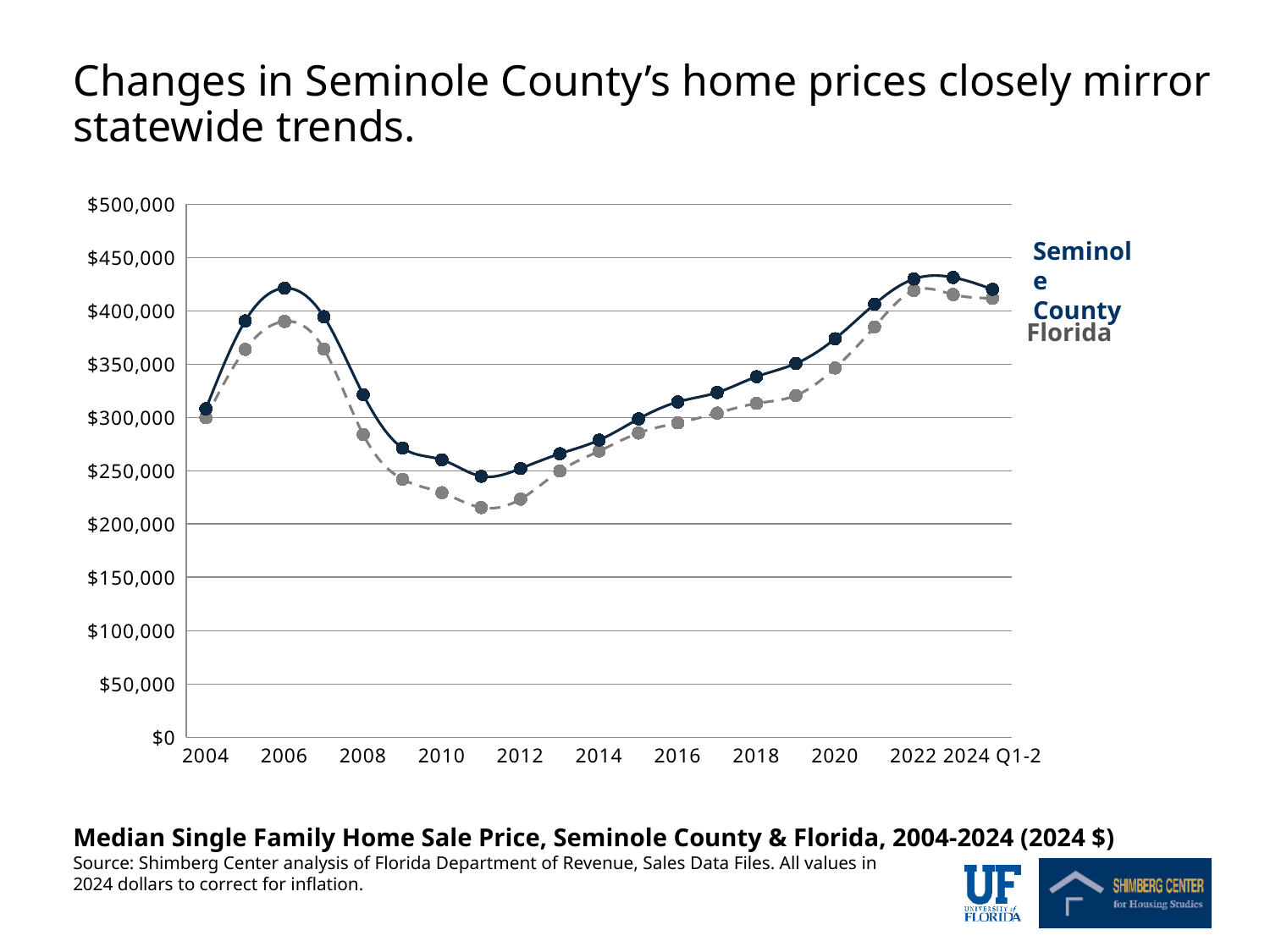
For Seminole County, which year has the lowest median sale price? 2011 Is the Seminole County value for 2008 greater or less than $300,000? greater In 2006, which series has the higher median sale price, Seminole County or Florida? Seminole County Do Seminole County's median sale prices rise or fall between 2006 and 2011? Fall How many data points does each line in the chart have? 21 Is the Florida value for 2011 greater or less than $250,000? less How many series does the chart plot? 2 Which series is drawn with a gray dashed line? Florida Is the Seminole County value for 2006 greater or less than $400,000? greater Which two series are plotted in the chart? Seminole County and Florida What kind of chart is shown on the slide? Line chart